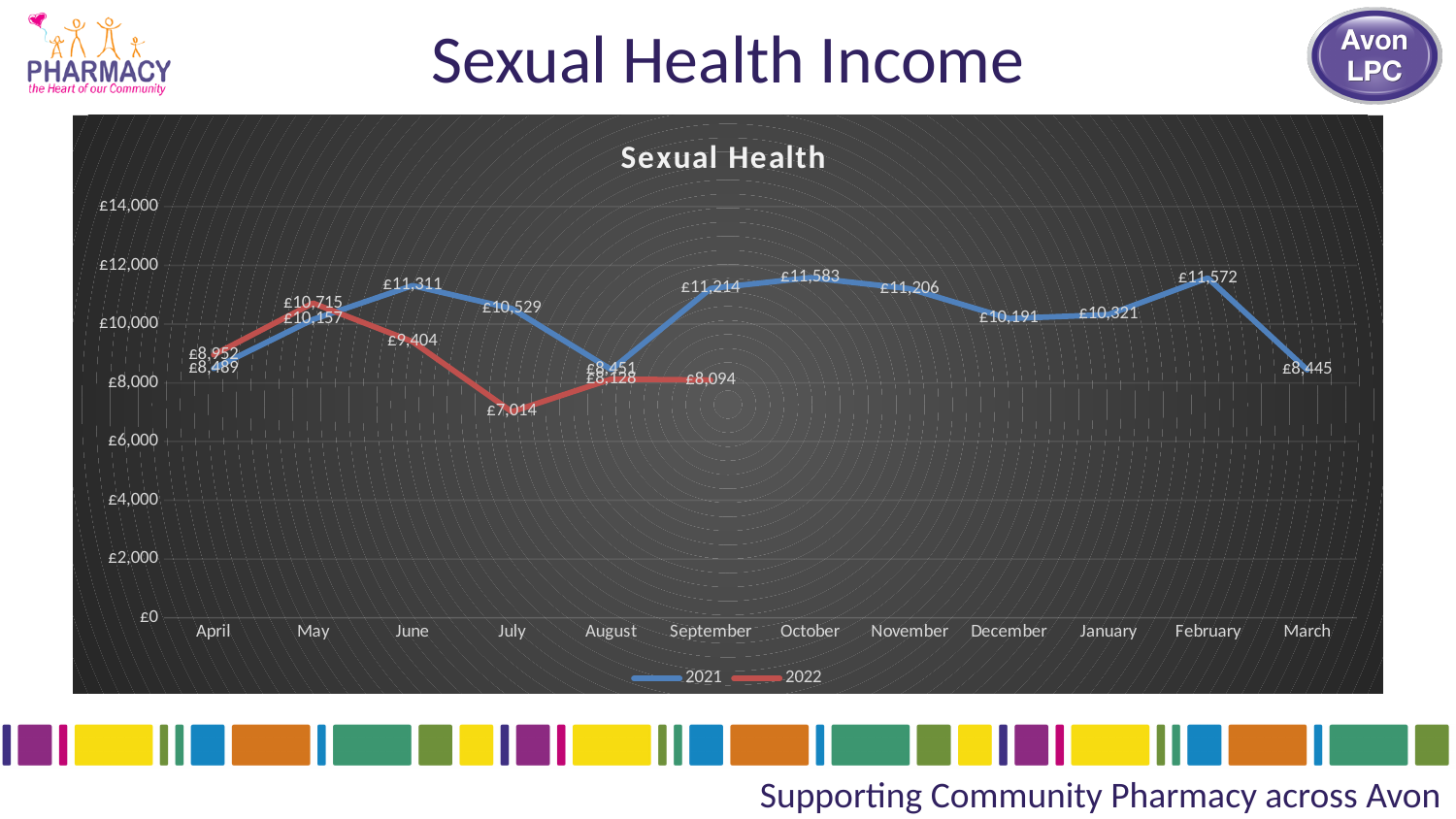
Which is larger in May, the 2021 value or the 2022 value? 2022 What is the 2022 value for July? £7,014 In which month is the 2022 value lowest? July How many months are shown on the x axis? 12 What is the 2022 value for September? £8,094 How many series does the legend list? 2 Is the 2021 value for March greater or less than £10,000? less What is the 2021 value for November? £11,206 What is the difference between the 2021 and 2022 values for June? £1,907 What is the 2021 value for June? £11,311 Does the 2022 line rise or fall from May to July? fall What kind of chart is shown on the slide? line chart